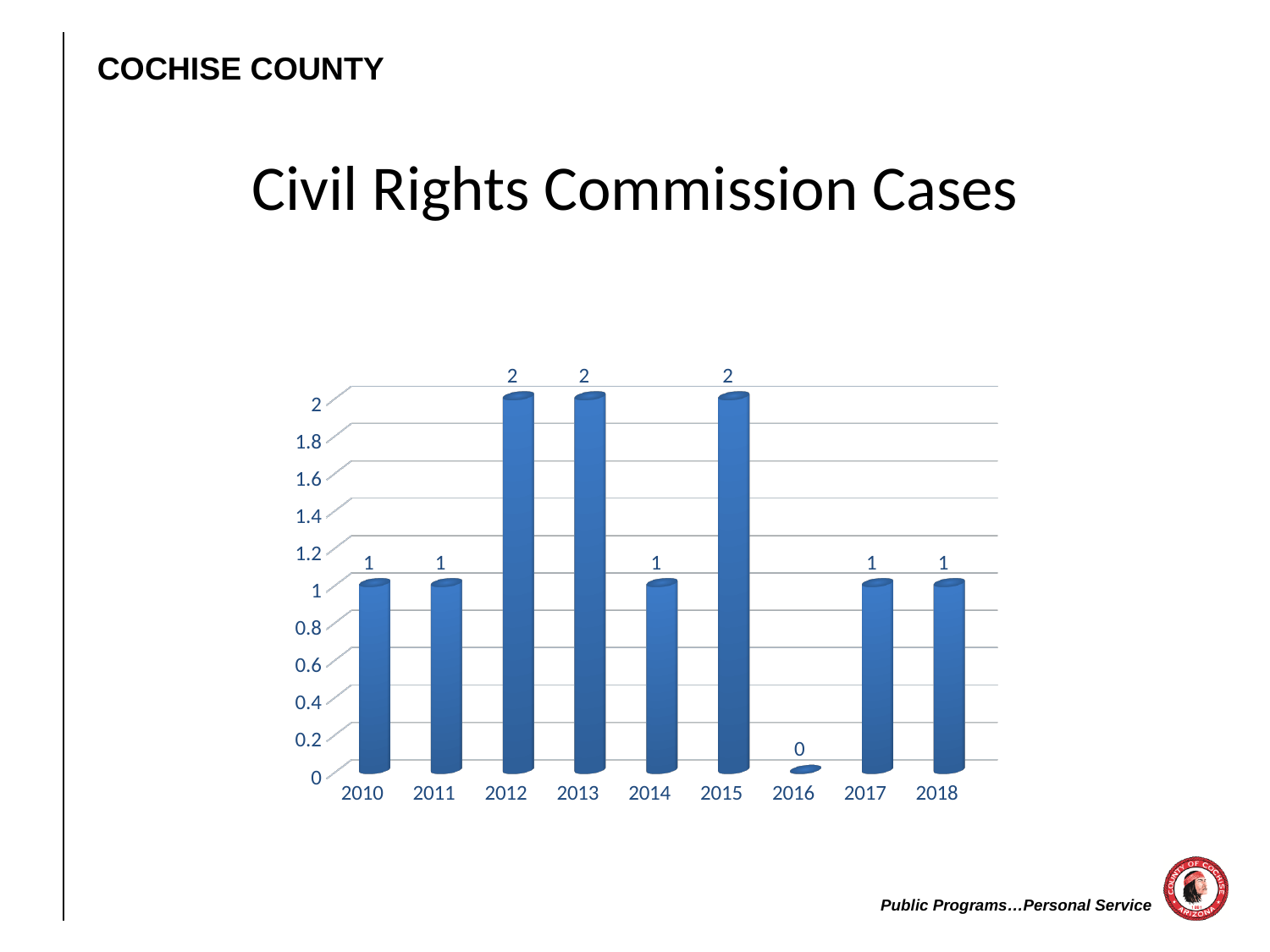
Which year has the lowest value? 2016 Is the value for 2011 greater or less than 1.4? less What is the value for 2010? 1 Which is larger, the value for 2013 or the value for 2017? 2013 What is the difference between the values for 2015 and 2014? 1 What is the value for 2016? 0 What is the value for 2012? 2 What kind of chart is this? bar chart What is the title of the chart? Civil Rights Commission Cases How many years are shown on the x axis? 9 How many years have a value of 2? 3 What is the value for 2018? 1